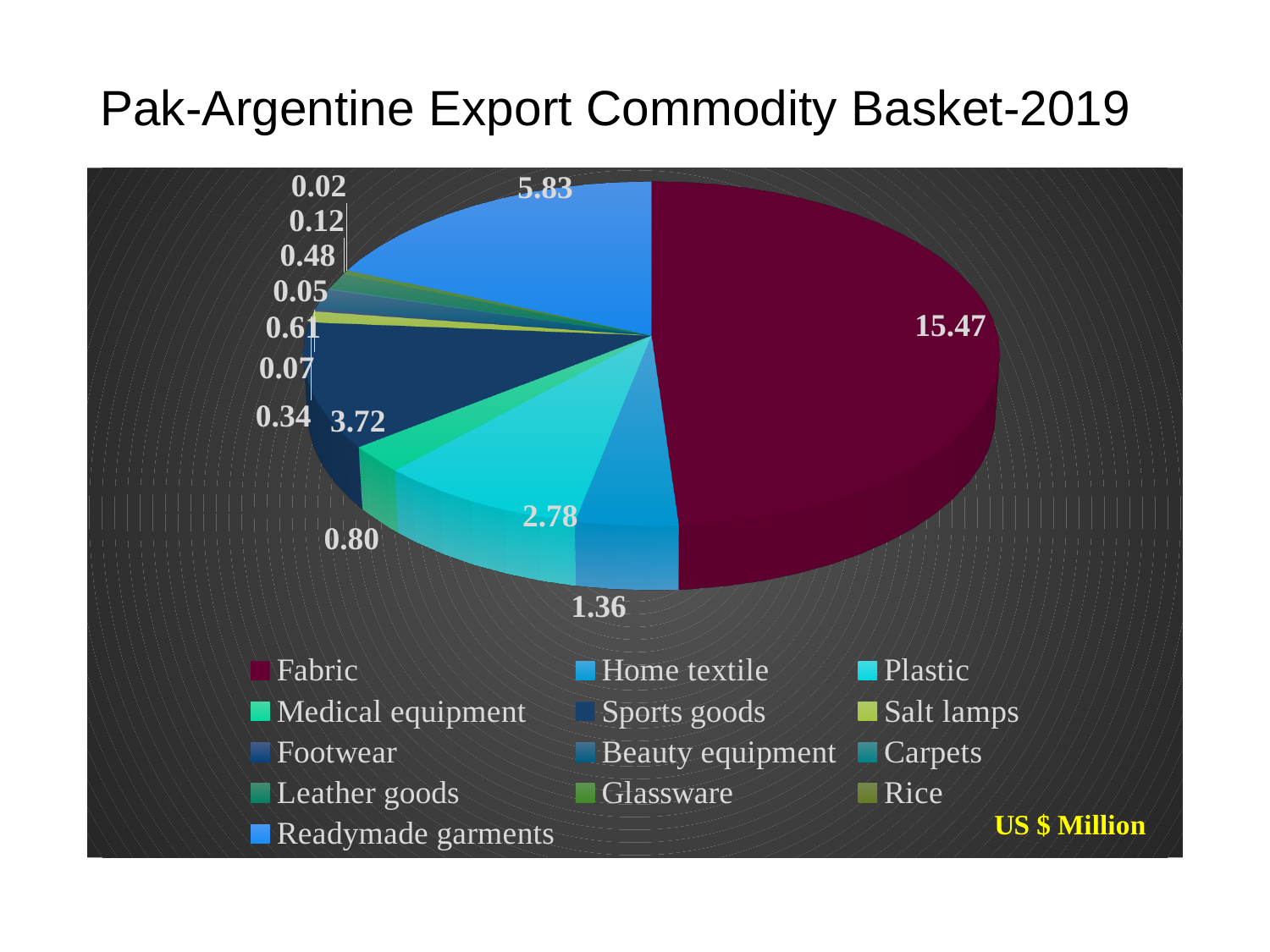
What is the value for Sports goods? 3.72 What is the difference between the values for Sports goods and Plastic? 0.94 What is the value for Plastic? 2.78 In what unit are the values on the chart expressed? US $ Million How many commodity categories does the legend list? 13 Which commodity has the largest slice of the pie? Fabric What is the value for Readymade garments? 5.83 What is the value for Fabric? 15.47 What is the value for Home textile? 1.36 What is the difference between the values for Fabric and Readymade garments? 9.64 What kind of chart is shown on the slide? Pie chart Which is larger, the value for Plastic or the value for Home textile? Plastic